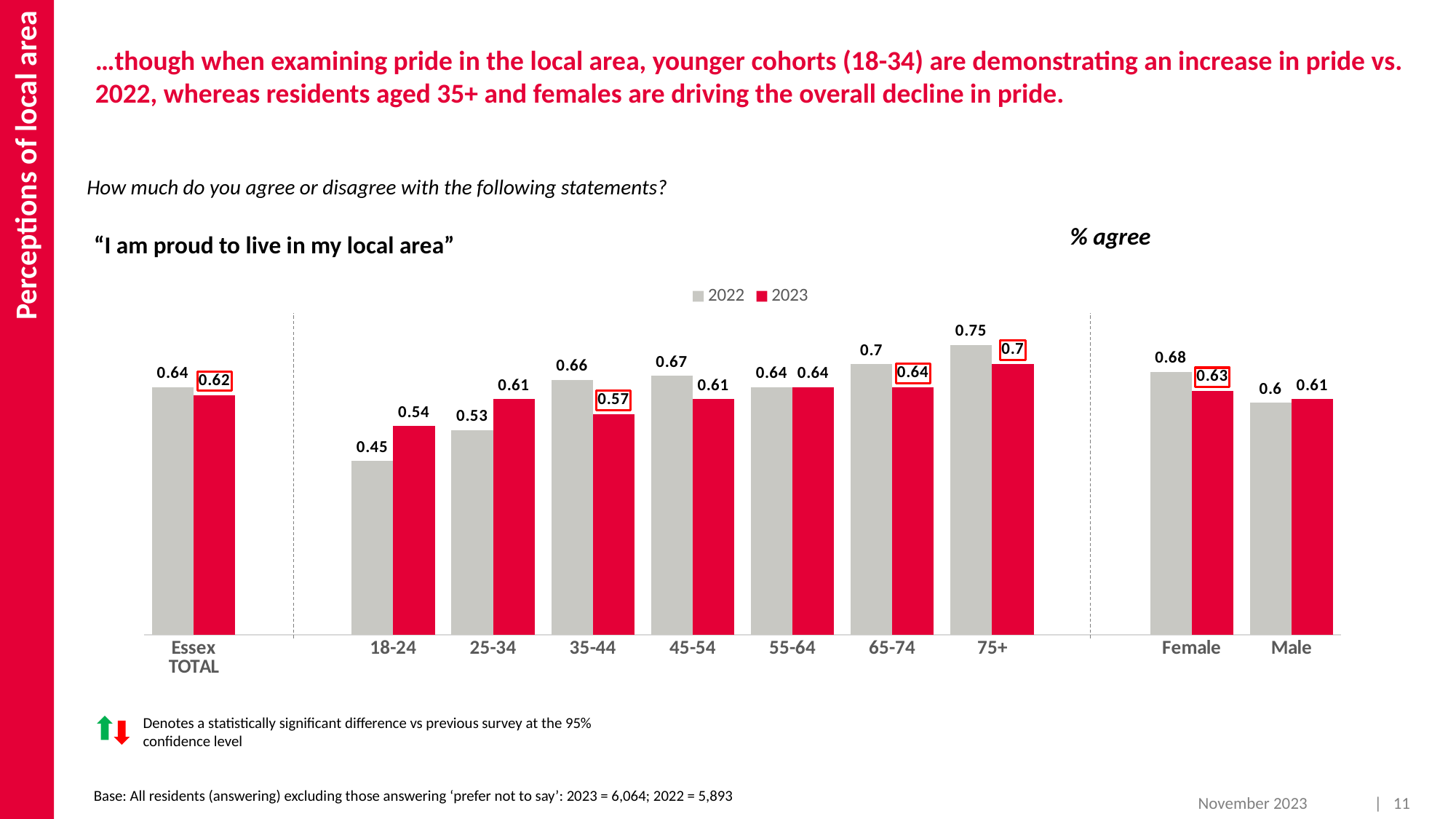
Which category has the same value in 2022 and 2023? 55-64 How many categories are shown on the x axis? 10 What is the 2022 value for Female? 0.68 Which category has the highest 2022 value? 75+ What is the 2023 value for the 18-24 age group? 0.54 What is the difference between the 2022 and 2023 values for the 35-44 age group? 0.09 How many series does the legend list? 2 What is the 2023 value for Essex TOTAL? 0.62 Which is larger for the 25-34 age group, the 2022 value or the 2023 value? 2023 What statement is the chart about? "I am proud to live in my local area" What kind of chart is shown on the slide? Bar chart Which category has the lowest 2023 value? 18-24